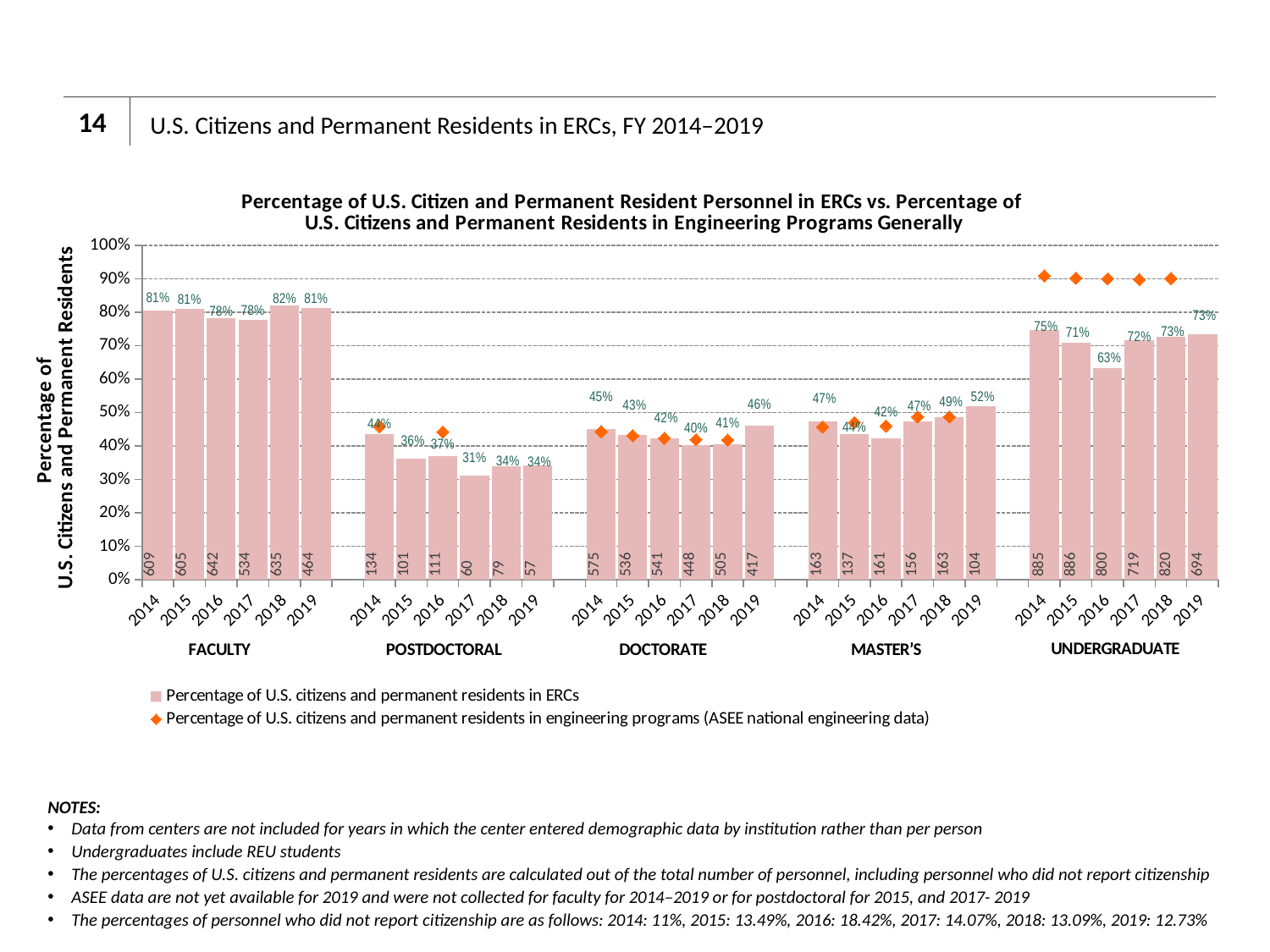
What is the percentage of U.S. citizens and permanent residents in ERCs for Undergraduate in 2016? 63% How many personnel groups are shown along the x axis? 5 What kind of chart is used to show the percentage of U.S. citizens and permanent residents in ERCs? Bar chart What is the percentage of U.S. citizens and permanent residents in ERCs for Postdoctoral in 2017? 31% Which year has the highest percentage of U.S. citizens and permanent residents in ERCs within the Master's group? 2019 How many series does the legend list? 2 What is the difference between the Undergraduate percentage in 2014 and in 2016? 12% Which is larger: the Doctorate percentage in 2019 or the Master's percentage in 2019? Master's 2019 What is the number printed inside the Doctorate bar for 2014? 575 What is the percentage of U.S. citizens and permanent residents in ERCs for Faculty in 2018? 82% Is the ASEE national engineering data marker for Undergraduate in 2014 greater or less than 80%? greater Which year has the lowest percentage of U.S. citizens and permanent residents in ERCs within the Postdoctoral group? 2017